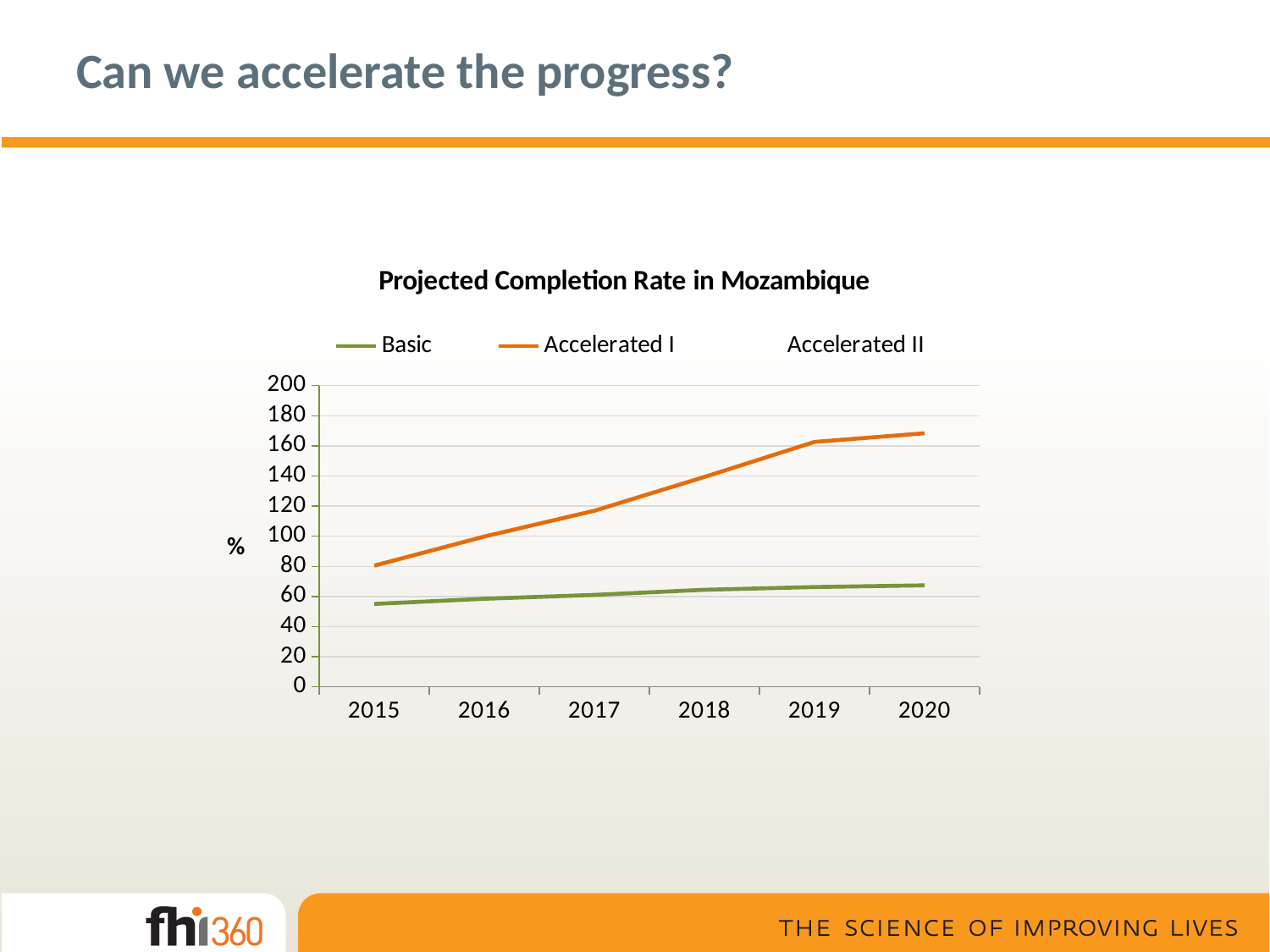
What is the title of the chart? Projected Completion Rate in Mozambique Does the Accelerated I line rise or fall from 2015 to 2020? rise Is the value for Accelerated I in 2018 greater or less than 120? greater Is the value for Accelerated I in 2015 greater or less than 100? less How many series does the legend list? 3 In which year is the Accelerated I value lowest? 2015 Is the value for Basic in 2015 greater or less than 60? less What kind of chart is shown on the slide? line chart In 2019, which is larger: the Basic value or the Accelerated I value? Accelerated I How many years are shown on the x axis? 6 Does the Basic line rise or fall from 2015 to 2020? rise